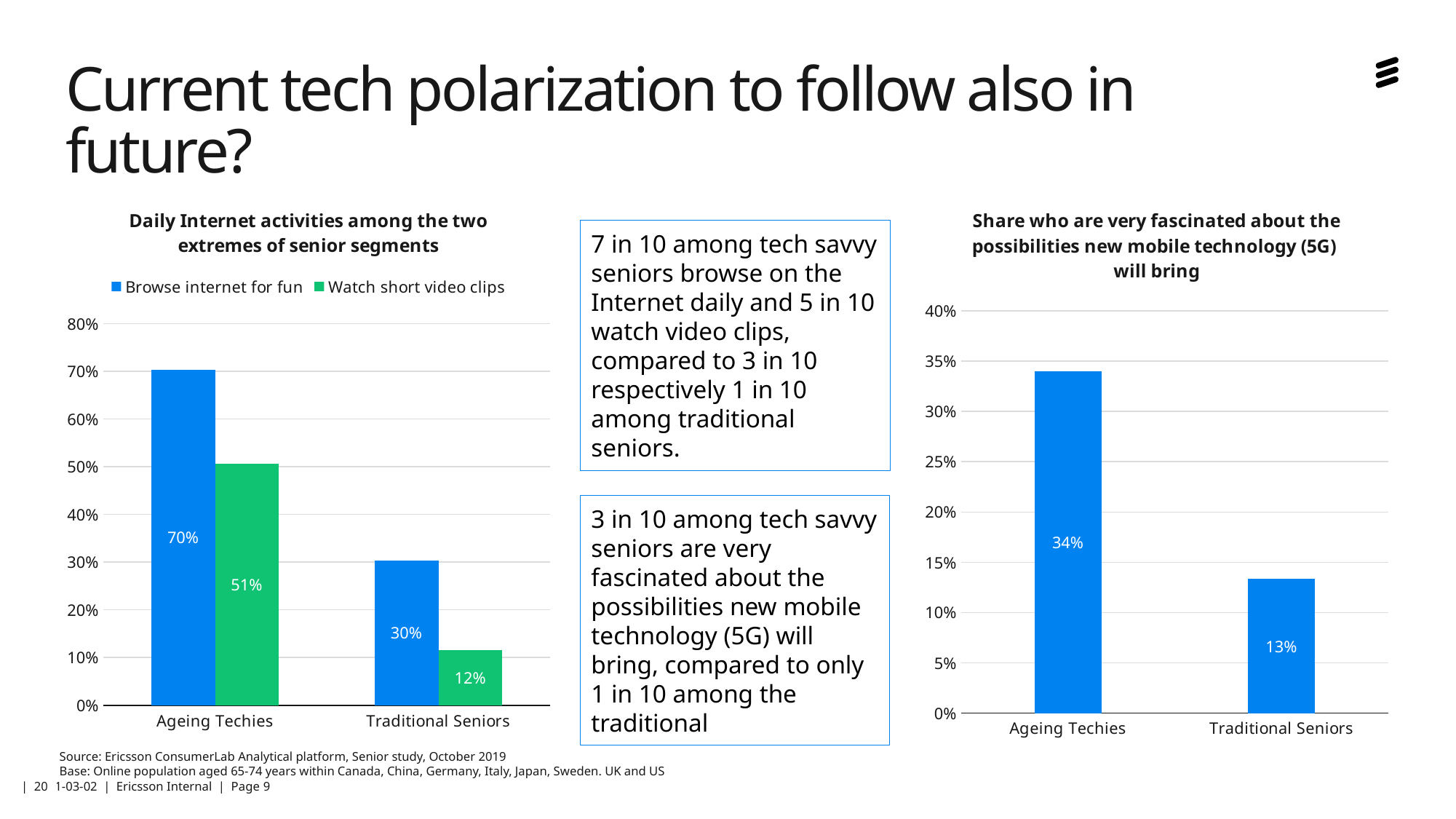
In the 'Daily Internet activities among the two extremes of senior segments' chart, which segment has the lowest value for 'Watch short video clips'? Traditional Seniors In the 'Daily Internet activities among the two extremes of senior segments' chart, what is the value for 'Browse internet for fun' among Ageing Techies? 70% In the 'Daily Internet activities among the two extremes of senior segments' chart, how many series does the legend list? 2 In the 'Daily Internet activities among the two extremes of senior segments' chart, what is the value for 'Watch short video clips' among Traditional Seniors? 12% In the 'Share who are very fascinated about the possibilities new mobile technology (5G) will bring' chart, how many categories are shown on the x axis? 2 What kind of chart is the 'Share who are very fascinated about the possibilities new mobile technology (5G) will bring' chart? Bar chart In the 'Share who are very fascinated about the possibilities new mobile technology (5G) will bring' chart, what is the value for Ageing Techies? 34% In the 'Daily Internet activities among the two extremes of senior segments' chart, what is the difference between 'Browse internet for fun' and 'Watch short video clips' for Ageing Techies? 19% In the 'Share who are very fascinated about the possibilities new mobile technology (5G) will bring' chart, which category is highest? Ageing Techies In the 'Daily Internet activities among the two extremes of senior segments' chart, which colour represents 'Watch short video clips'? Green In the 'Share who are very fascinated about the possibilities new mobile technology (5G) will bring' chart, what is the difference between Ageing Techies and Traditional Seniors? 21% In the 'Share who are very fascinated about the possibilities new mobile technology (5G) will bring' chart, what is the value for Traditional Seniors? 13%